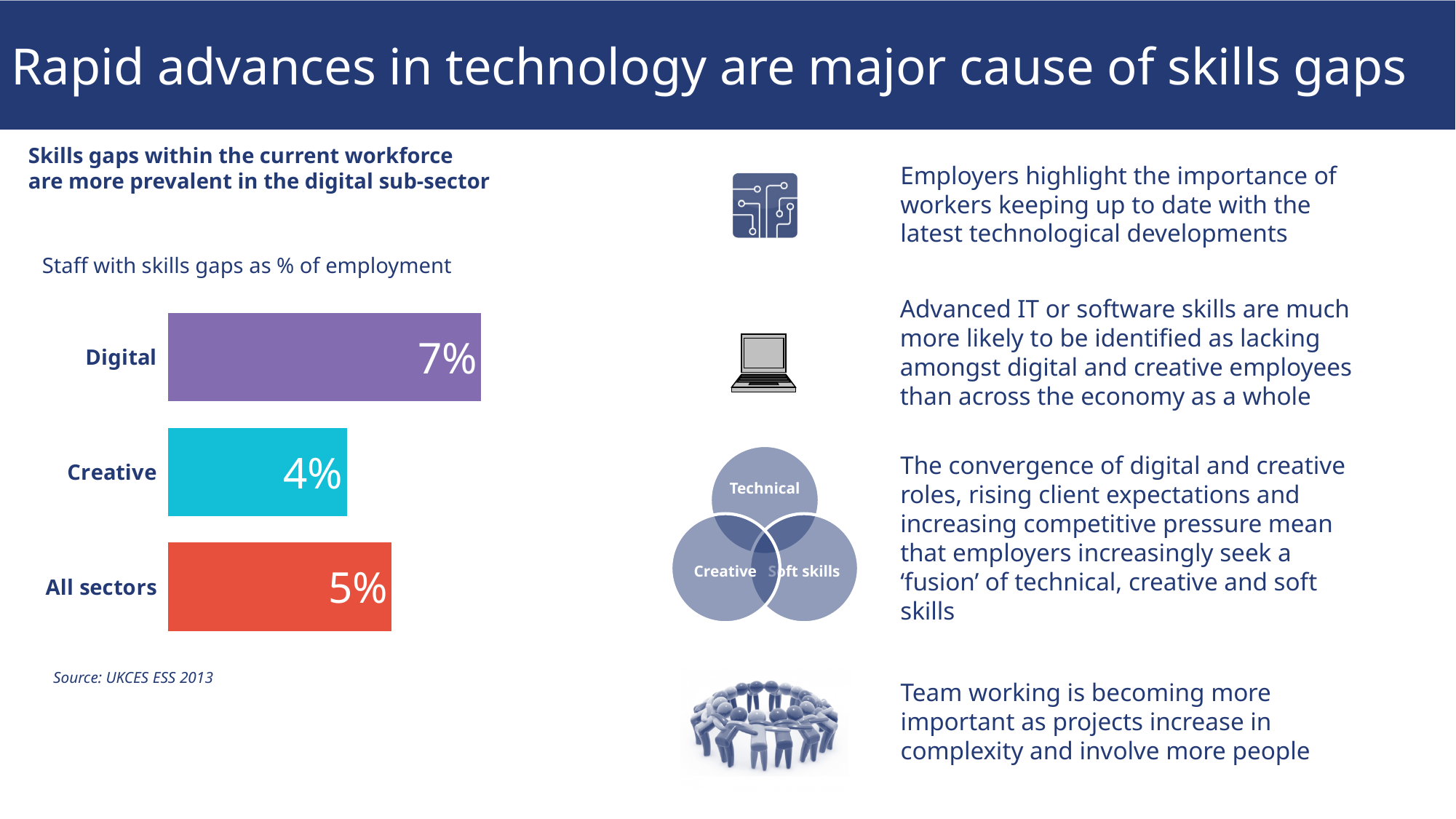
What is the value for Digital in the chart 'Staff with skills gaps as % of employment'? 7% What is the difference between the All sectors and Creative values in the chart 'Staff with skills gaps as % of employment'? 1% How many categories are shown in the chart 'Staff with skills gaps as % of employment'? 3 Which category has the lowest value in the chart 'Staff with skills gaps as % of employment'? Creative What is the value for All sectors in the chart 'Staff with skills gaps as % of employment'? 5% Which category has the highest value in the chart 'Staff with skills gaps as % of employment'? Digital What is the value for Creative in the chart 'Staff with skills gaps as % of employment'? 4% What kind of chart is 'Staff with skills gaps as % of employment'? Bar chart Which is larger in the chart 'Staff with skills gaps as % of employment': Digital or All sectors? Digital What is the title of the chart on the left of the slide? Staff with skills gaps as % of employment What is the difference between the Digital and Creative values in the chart 'Staff with skills gaps as % of employment'? 3% What colour is the Creative bar in the chart 'Staff with skills gaps as % of employment'? Cyan